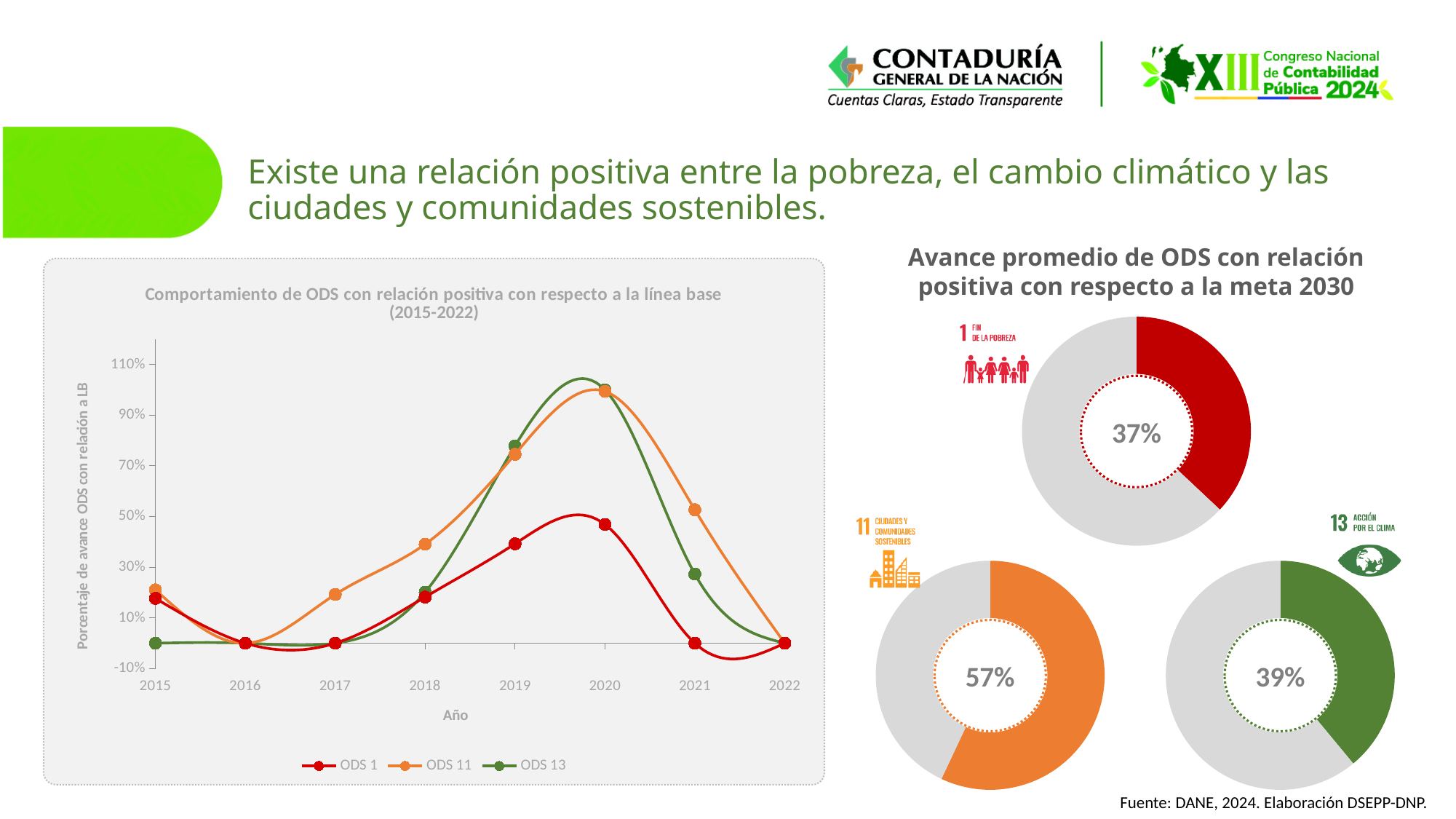
In the line chart on the left, is the value for ODS 13 in 2019 greater or less than 70%? greater In the donut charts on the right, what is the difference between the progress of ODS 11 and ODS 1? 20 percentage points In the line chart on the left, which series has the larger value in 2021, ODS 11 or ODS 13? ODS 11 What kind of chart is the chart titled 'Comportamiento de ODS con relación positiva con respecto a la línea base (2015-2022)'? line chart Among the three donut charts on the right, which ODS shows the highest average progress toward the 2030 goal? ODS 11 In the donut charts on the right, what is the average progress shown for ODS 1 (Fin de la pobreza)? 37% In the donut charts on the right, what is the average progress shown for ODS 11 (Ciudades y comunidades sostenibles)? 57% In the line chart on the left, does the ODS 11 line rise or fall between 2016 and 2020? rise In the line chart on the left, how many series does the legend list? 3 In the line chart on the left, in which year does ODS 11 reach its highest value? 2020 In the line chart on the left, how many years are shown on the x axis? 8 In the line chart on the left, is the value for ODS 11 in 2020 greater or less than 90%? greater